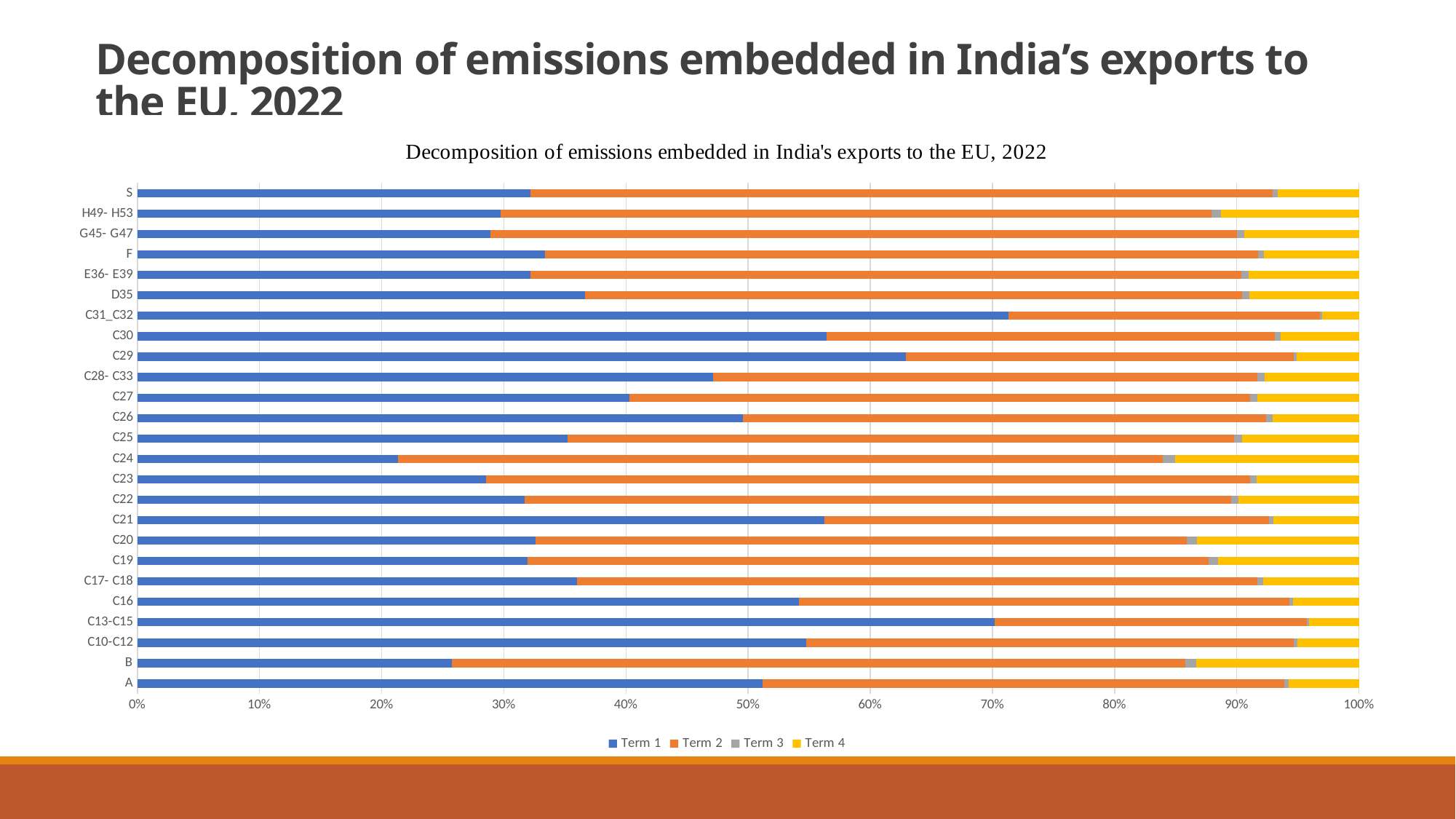
Which colour represents Term 4 in the legend? Yellow How many series does the legend list? 4 Is the Term 1 value for A greater or less than 40%? greater Is the Term 1 value for C24 greater or less than 30%? less Which has the larger Term 1 share, C29 or C27? C29 Is the Term 1 value for C31_C32 greater or less than 60%? greater Which has the larger Term 1 share, C16 or C20? C16 What is the title of the chart? Decomposition of emissions embedded in India's exports to the EU, 2022 How many categories are plotted on the vertical axis? 25 What kind of chart is shown on the slide? Stacked bar chart What is the total of the stacked bar for category A? 100% Which category has the lowest Term 1 share? C24